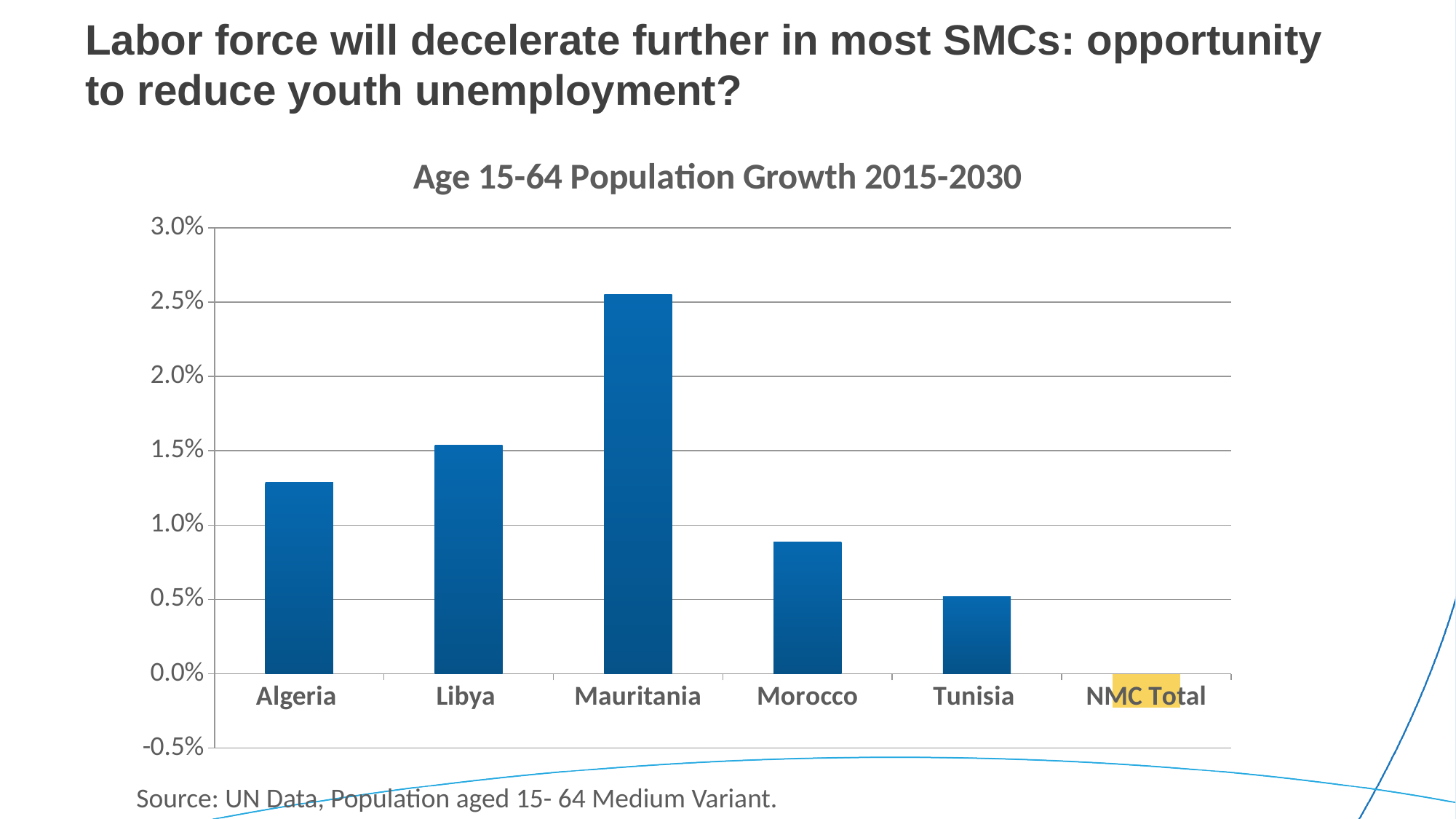
Which has the higher Age 15-64 population growth, Morocco or Tunisia? Morocco Which category has the highest Age 15-64 population growth 2015-2030? Mauritania Is the value for Tunisia greater or less than 1.0%? less Among the five countries shown, which has the lowest Age 15-64 population growth 2015-2030? Tunisia Is the value for Libya greater or less than 2.0%? less What kind of chart is shown on the slide? Bar chart Is the value for Algeria greater or less than 1.0%? greater How many categories are shown on the x axis of the chart? 6 Which has the higher Age 15-64 population growth, Algeria or Libya? Libya What is the title of the chart? Age 15-64 Population Growth 2015-2030